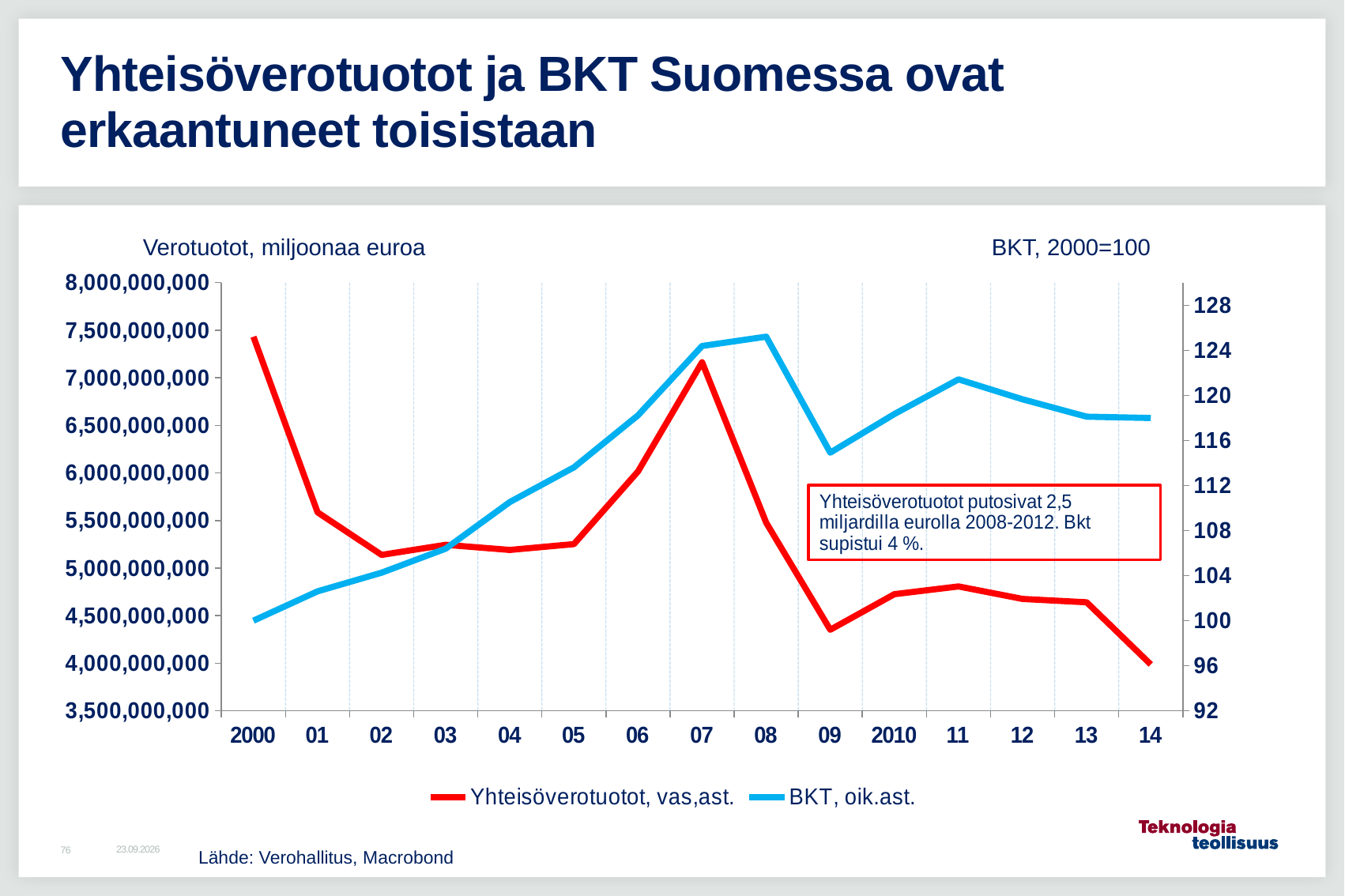
What kind of chart is shown on the slide? line chart Which is larger, the Yhteisöverotuotot value in 2000 or in 14? 2000 Is the value for BKT in 14 greater or less than 116? greater Is the value for Yhteisöverotuotot in 2000 greater or less than 7,000,000,000? greater In which year is the Yhteisöverotuotot series at its lowest? 14 Does the Yhteisöverotuotot series rise or fall from 07 to 09? fall Does the BKT series rise or fall from 2000 to 07? rise How many series does the legend list? 2 In which year is the BKT series at its lowest? 2000 Is the value for Yhteisöverotuotot in 09 greater or less than 4,500,000,000? less How many years are plotted along the x axis? 15 What is the label of the right-hand axis? BKT, 2000=100